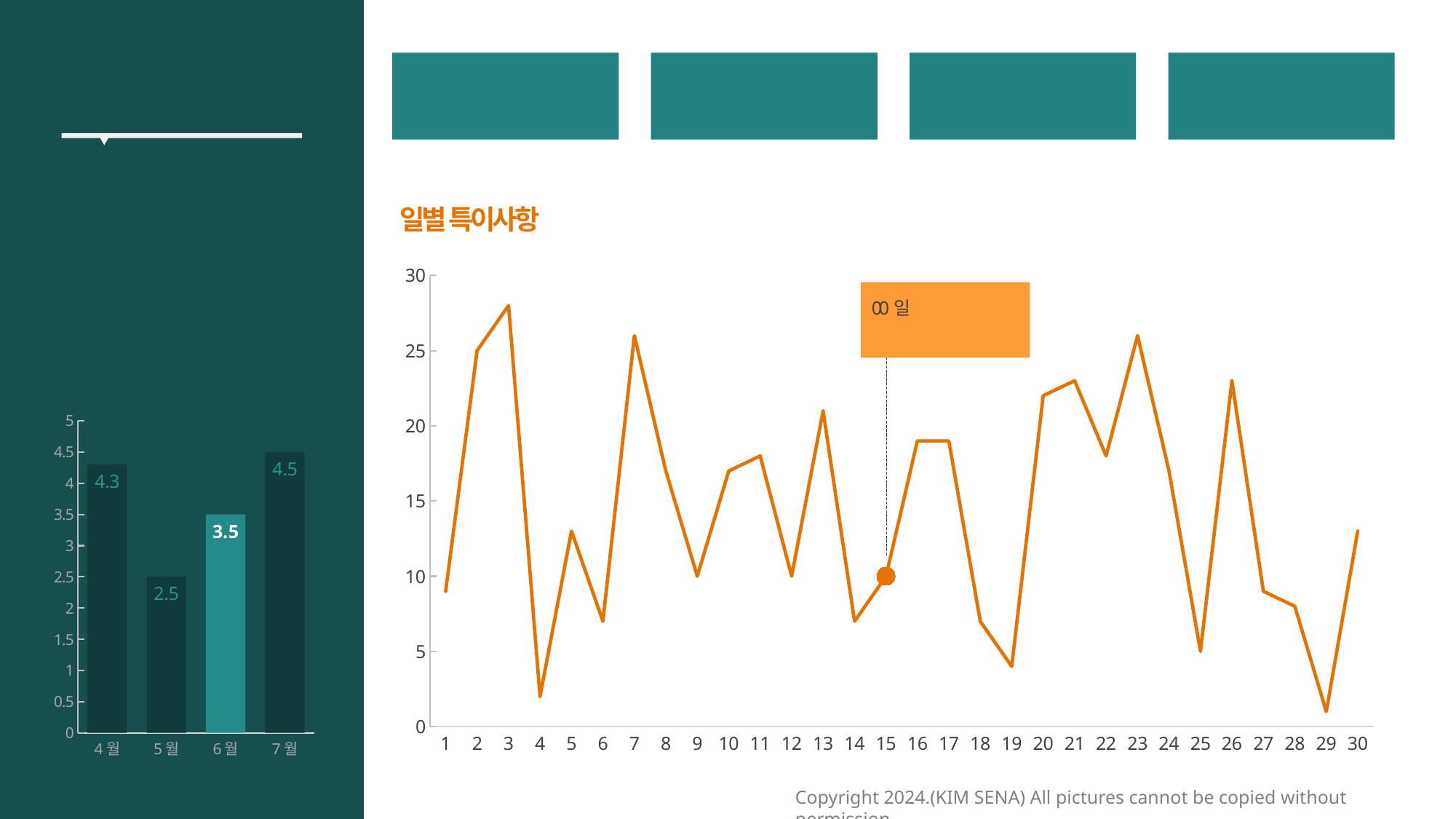
On the chart titled 일별 특이사항, how many days are shown on the x axis? 30 On the chart titled 일별 특이사항, is the value for day 4 greater or less than 5? less On the chart titled 일별 특이사항, is the value for day 7 greater or less than 25? greater On the left bar chart, which month has the lowest value? 5월 On the left bar chart, which is larger, the value for 4월 or the value for 6월? 4월 On the left bar chart, what is the value for 6월? 3.5 On the left bar chart, what is the difference between the values for 7월 and 4월? 0.2 What kind of chart is the chart titled 일별 특이사항? line chart On the left bar chart, what is the value for 4월? 4.3 On the chart titled 일별 특이사항, which day has the highest value? 3 On the left bar chart, how many months are shown? 4 On the left bar chart, which month has the highest value? 7월